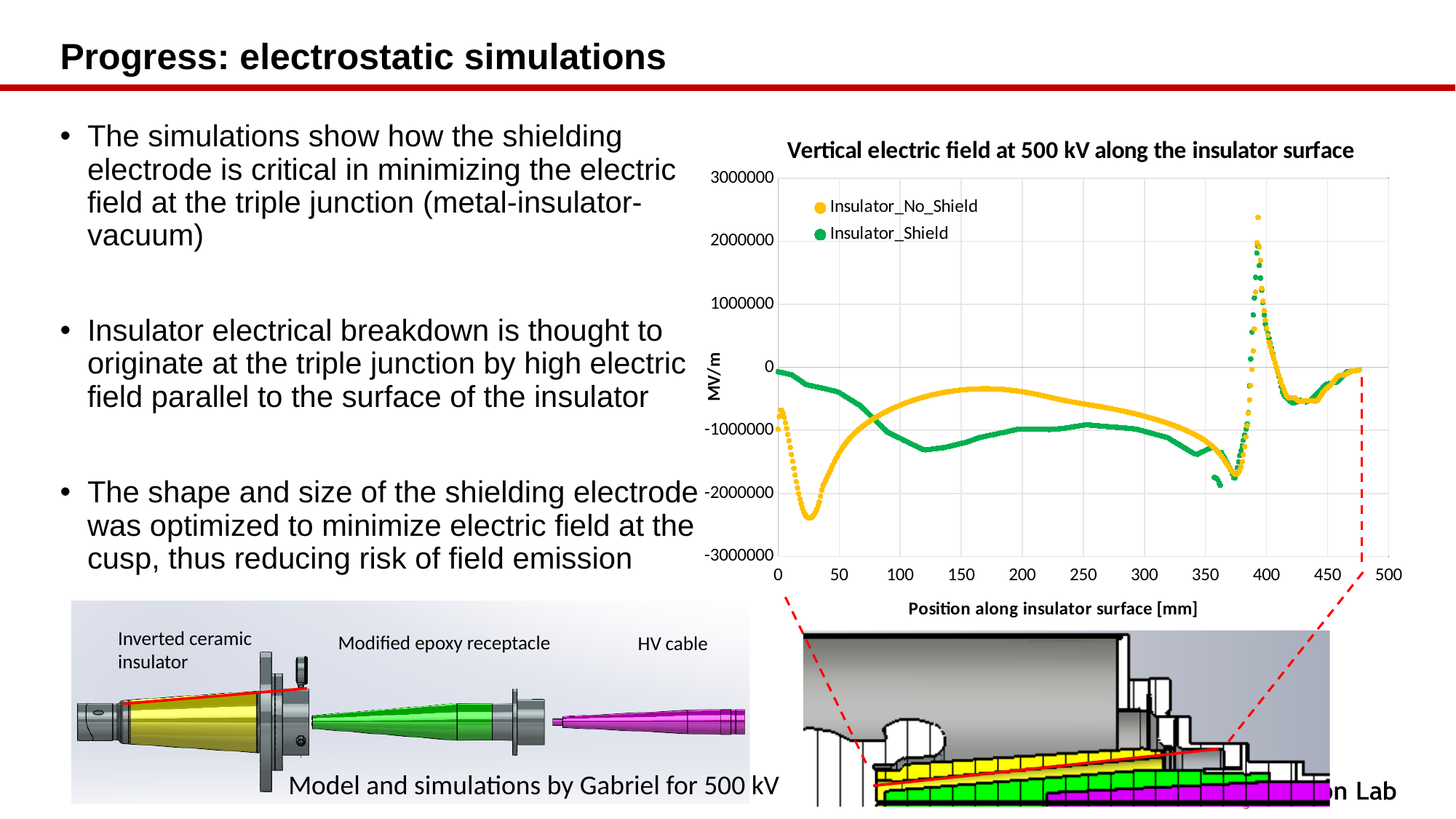
Which series reaches the highest value on the chart? Insulator_No_Shield Is the value for Insulator_No_Shield at about 170 mm greater or less than -1000000? greater Is the value for Insulator_Shield at 0 mm greater or less than -1000000? greater Which series reaches the lowest value on the chart? Insulator_No_Shield What kind of chart is shown on the slide? Scatter chart At about 120 mm, which series has the lower value, Insulator_No_Shield or Insulator_Shield? Insulator_Shield What is the label of the x axis of the chart? Position along insulator surface [mm] Is the value for Insulator_No_Shield at about 25 mm greater or less than -2000000? less How many series does the chart legend list? 2 What is the title of the chart? Vertical electric field at 500 kV along the insulator surface